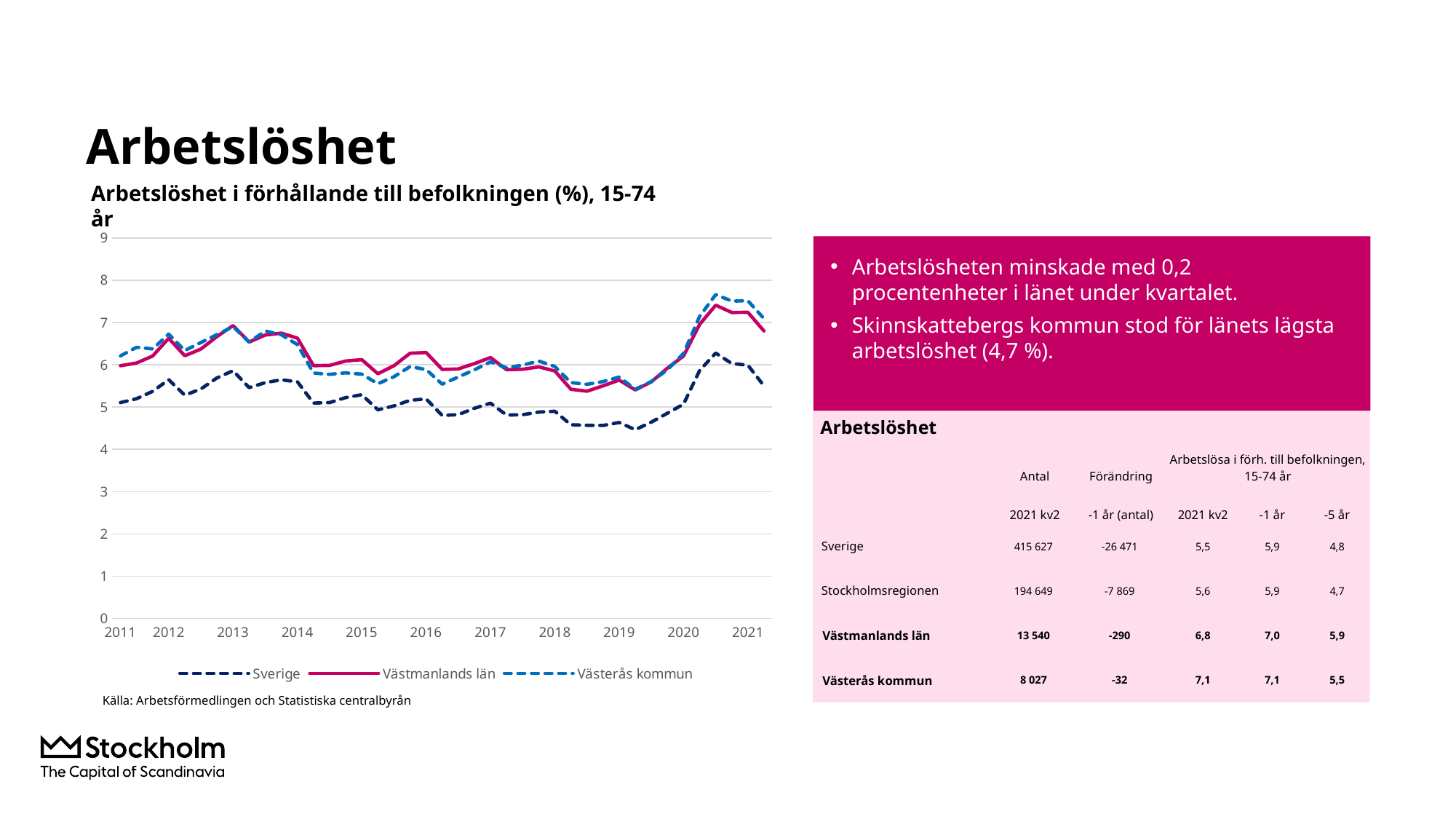
Does the Sverige line rise or fall between 2013 and 2019? fall Which series has the lowest values across the whole chart? Sverige Is the peak value for Västerås kommun around 2020 greater or less than 7? greater In 2015, which is higher: Sverige or Västmanlands län? Västmanlands län Is the value for Västmanlands län in 2013 greater or less than 6? greater Is the value for Sverige in 2016 greater or less than 6? less Which series are listed in the chart legend? Sverige, Västmanlands län, Västerås kommun What kind of chart is shown on the slide? line chart What is the title of the chart? Arbetslöshet i förhållande till befolkningen (%), 15-74 år How many year labels are shown on the x axis of the chart? 11 How many series does the chart legend list? 3